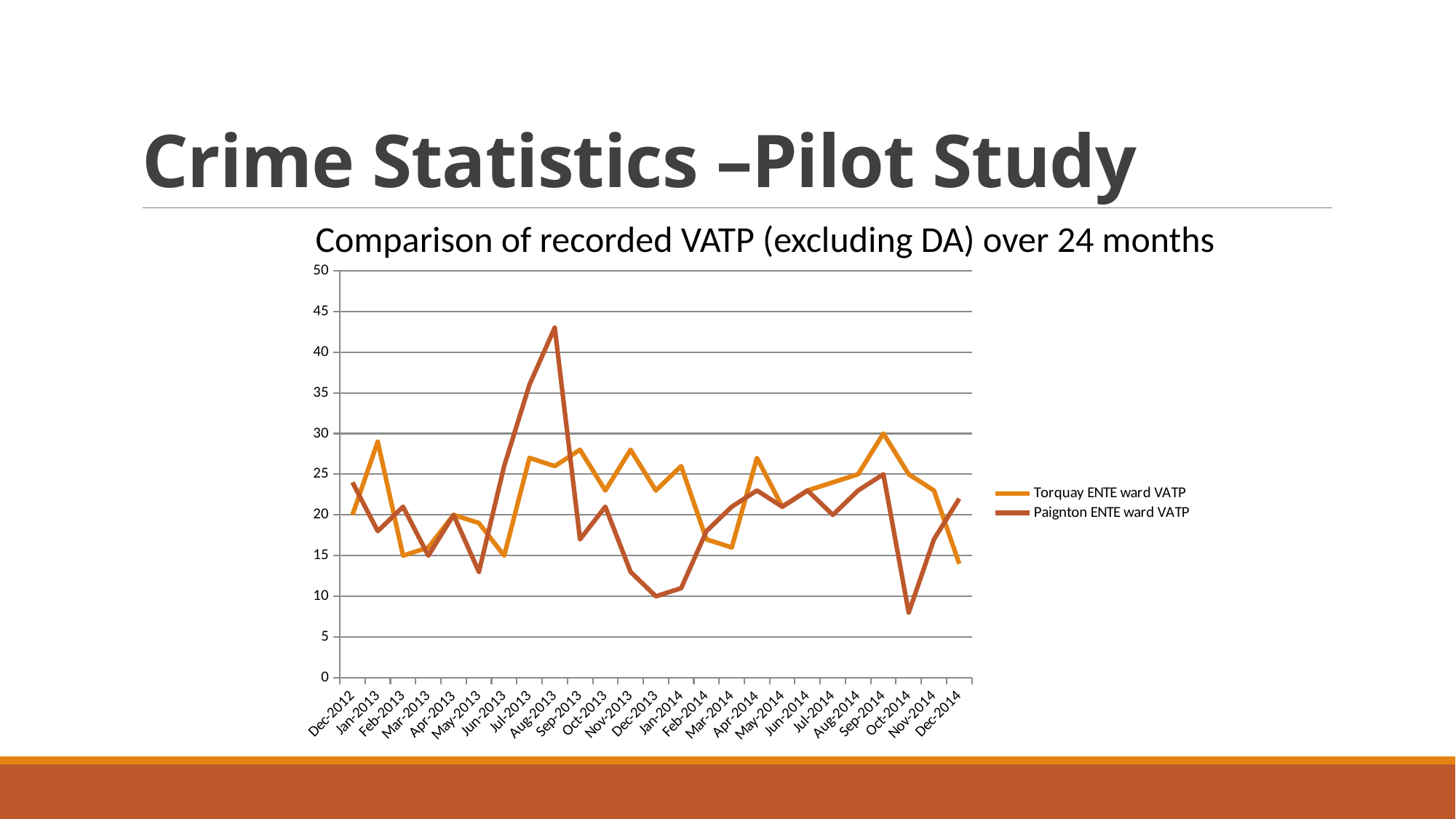
In which month does the Paignton ENTE ward VATP series reach its highest value? Aug-2013 In which month does the Paignton ENTE ward VATP series reach its lowest value? Oct-2014 What is the value for Torquay ENTE ward VATP in Sep-2014? 30 In Aug-2013, which series has the higher value, Torquay ENTE ward VATP or Paignton ENTE ward VATP? Paignton ENTE ward VATP How many months are plotted along the x axis? 25 Is the value for Paignton ENTE ward VATP in Oct-2014 greater or less than 10? less How many series does the legend list? 2 What is the value for Paignton ENTE ward VATP in Dec-2013? 10 In Dec-2013, which series has the higher value, Torquay ENTE ward VATP or Paignton ENTE ward VATP? Torquay ENTE ward VATP What kind of chart is shown on the slide? line chart Is the value for Paignton ENTE ward VATP in Aug-2013 greater or less than 40? greater What is the title of the chart? Comparison of recorded VATP (excluding DA) over 24 months